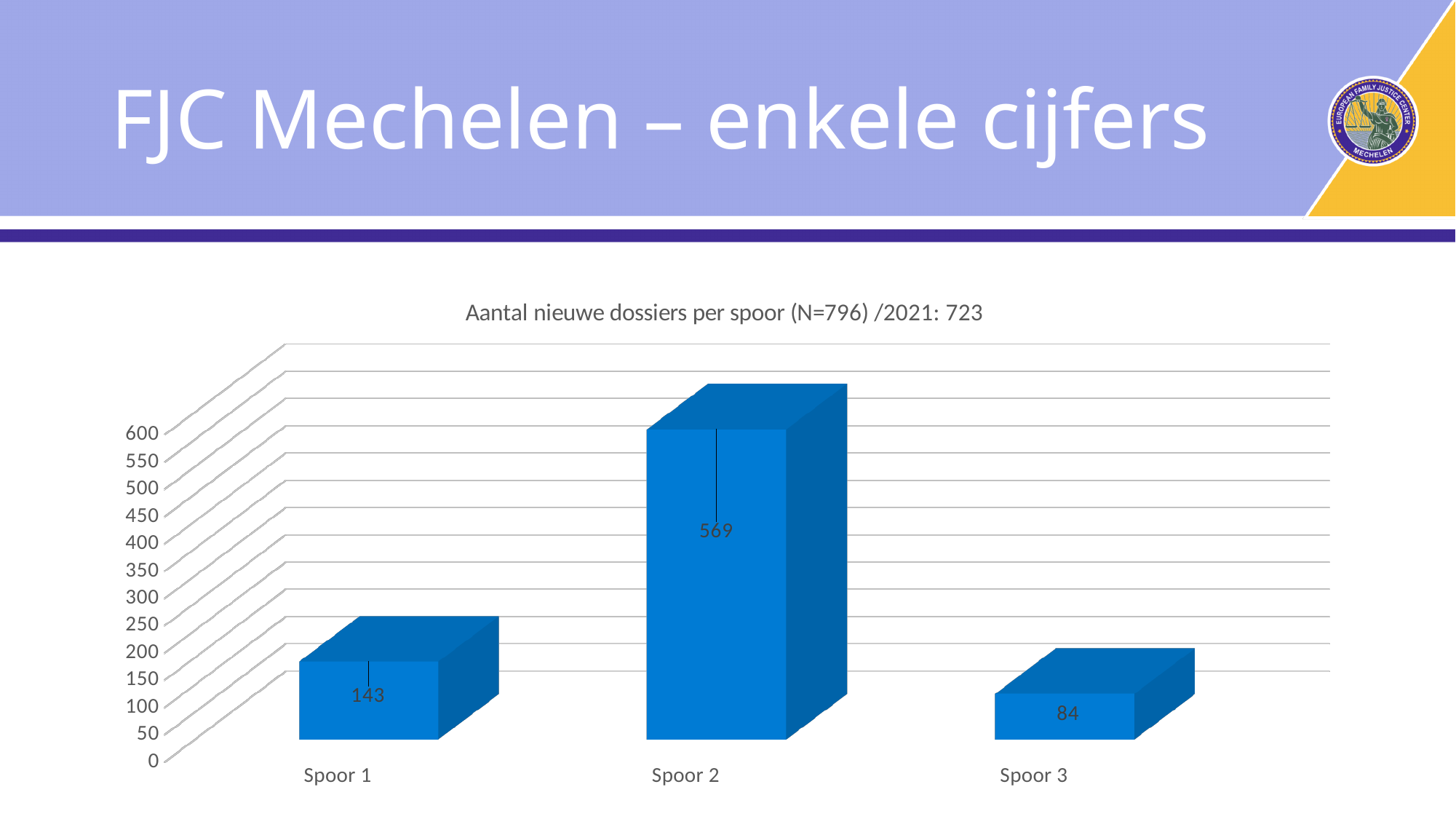
Which category has the highest value? Spoor 2 What is the value for Spoor 2? 569 What is the difference between the values for Spoor 2 and Spoor 1? 426 What is the value for Spoor 1? 143 Which category has the lowest value? Spoor 3 What is the difference between the values for Spoor 1 and Spoor 3? 59 How many categories are shown on the x axis? 3 What kind of chart is shown on the slide? bar chart Is the value for Spoor 2 greater or less than 500? greater What is the value for Spoor 3? 84 Which is larger, the value for Spoor 1 or the value for Spoor 3? Spoor 1 What is the title of the chart? Aantal nieuwe dossiers per spoor (N=796) /2021: 723